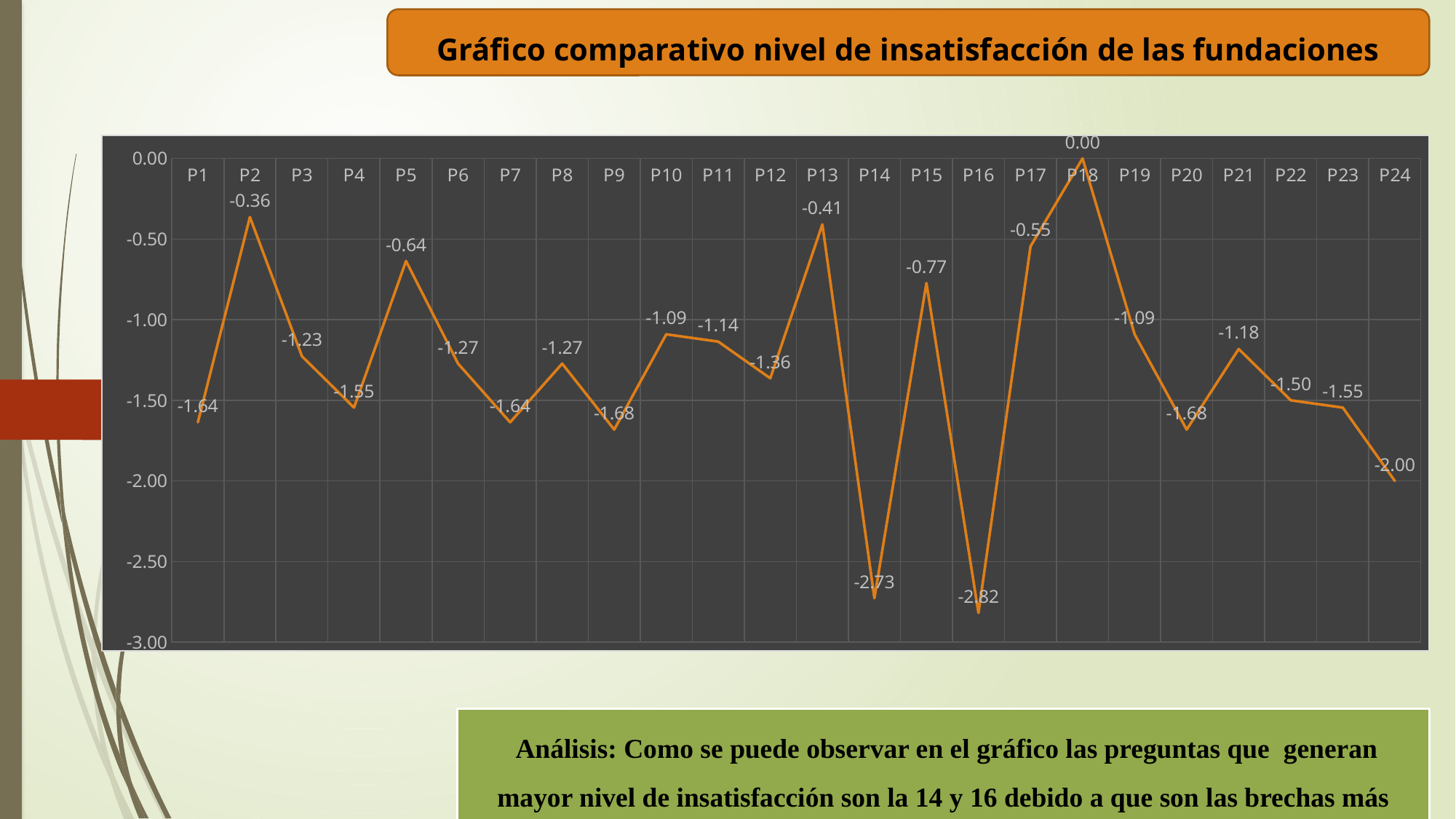
How many points (P1 to P24) are plotted on the chart? 24 What is the value for P24? -2.00 What is the difference between the values for P14 and P16? 0.09 What type of chart is shown on the slide? line chart What is the value for P2? -0.36 Which point has the lowest value? P16 Which point has the highest value? P18 What is the value for P14? -2.73 What is the title of the chart? Gráfico comparativo nivel de insatisfacción de las fundaciones Is the value for P14 greater or less than -2.50? less Which has the larger value, P13 or P15? P13 Do the values rise or fall from P21 to P24? fall